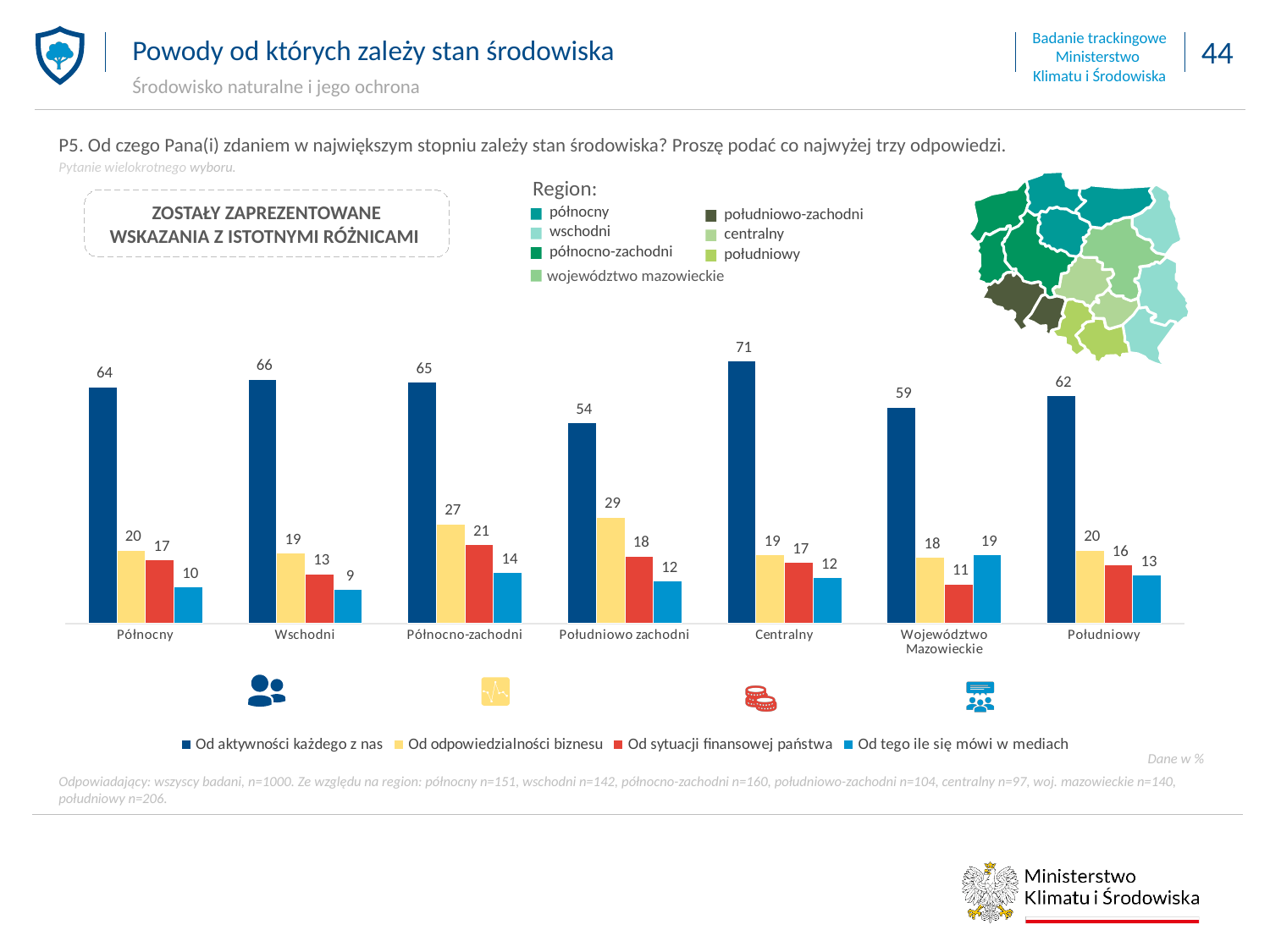
What is the difference between the "Od aktywności każdego z nas" values for Centralny and Południowo zachodni? 17 What type of chart is shown on the slide? Bar chart Which is larger in the Północno-zachodni region: "Od odpowiedzialności biznesu" or "Od sytuacji finansowej państwa"? Od odpowiedzialności biznesu What is the value for "Od aktywności każdego z nas" in the Centralny region? 71 Which region has the lowest value for "Od aktywności każdego z nas"? Południowo zachodni How many series does the chart legend list? 4 How many regions (categories) are shown on the x axis of the chart? 7 Which region has the highest value for "Od aktywności każdego z nas"? Centralny Which region has the lowest value for "Od tego ile się mówi w mediach"? Wschodni What is the value for "Od tego ile się mówi w mediach" in Województwo Mazowieckie? 19 What colour are the bars for "Od sytuacji finansowej państwa"? Red What is the value for "Od odpowiedzialności biznesu" in the Południowo zachodni region? 29